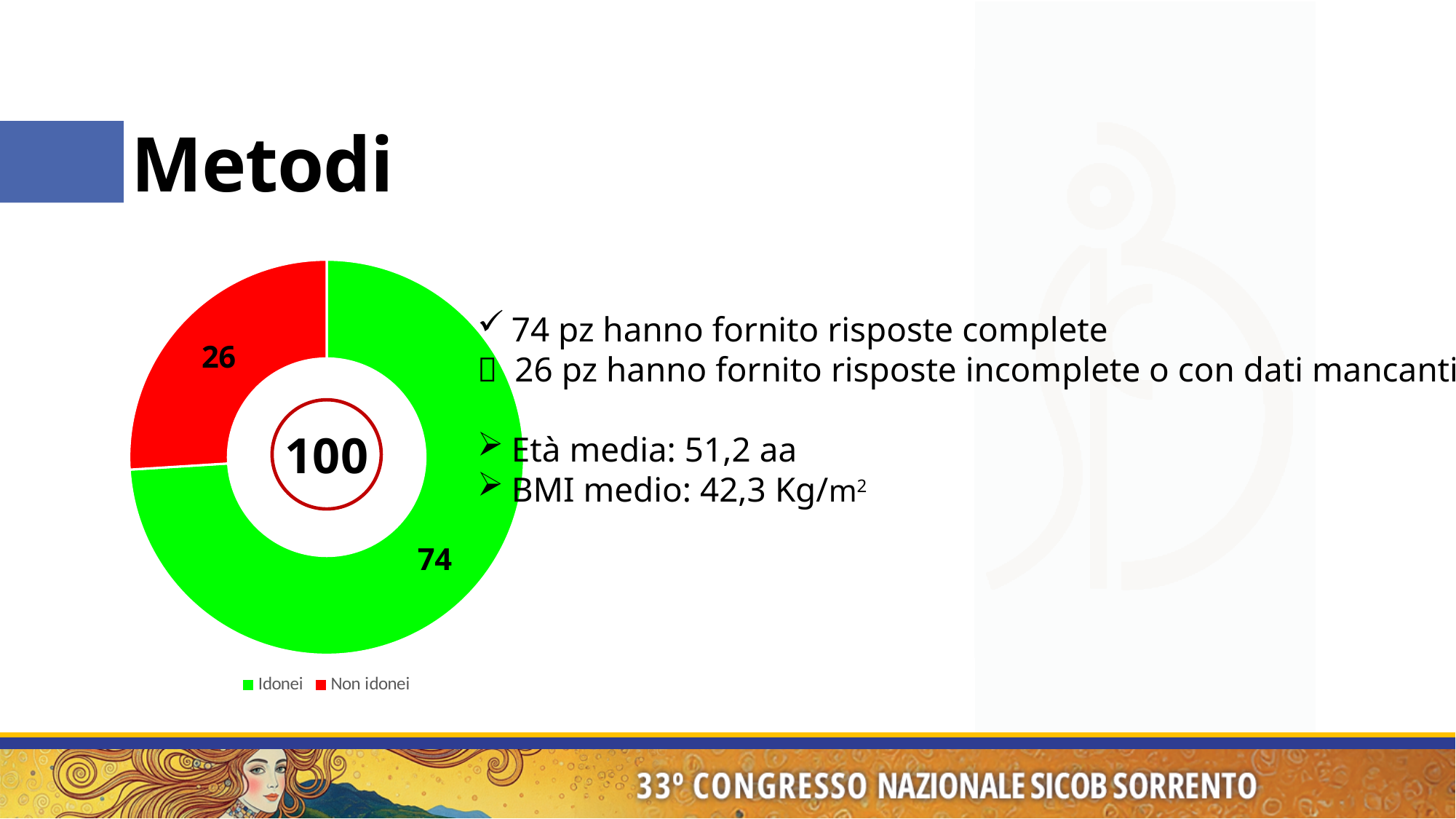
What kind of chart is shown on the slide? Doughnut chart What share of the total does the Non idonei slice represent? 26% What colour is the Idonei slice? Green What is the value for Non idonei? 26 Which category has the smallest value? Non idonei How many categories does the chart show? 2 Which category has the largest value? Idonei What number is printed in the centre of the doughnut chart? 100 Which is larger, Idonei or Non idonei? Idonei What is the total of the two slices in the chart? 100 What is the value for Idonei? 74 What is the difference between the values for Idonei and Non idonei? 48